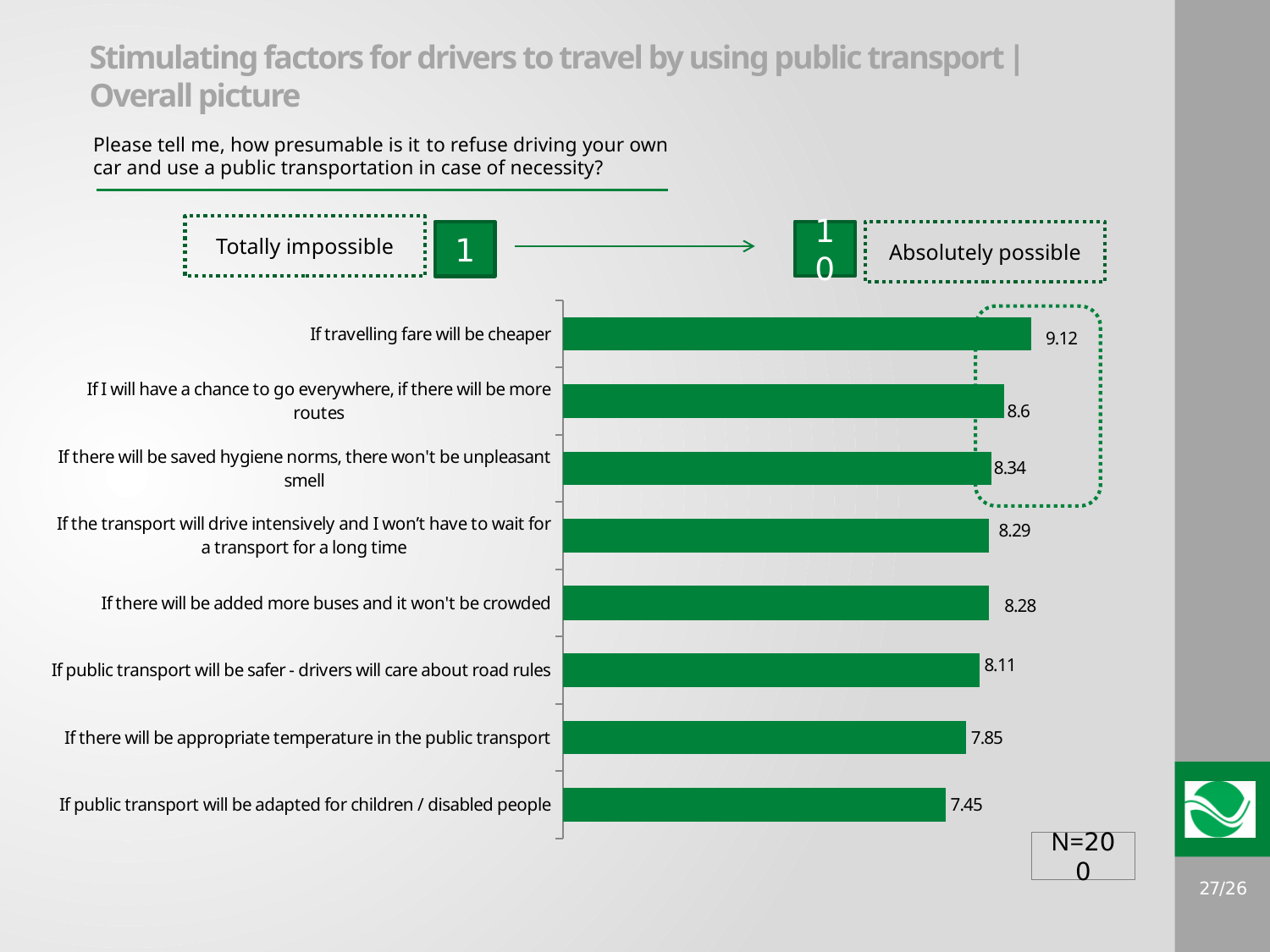
What is the difference between the values for "If travelling fare will be cheaper" and "If public transport will be adapted for children / disabled people"? 1.67 What sample size (N) is shown on the slide? N=200 Which has a larger value: "If there will be added more buses and it won't be crowded" or "If there will be appropriate temperature in the public transport"? If there will be added more buses and it won't be crowded What is the difference between the values for "If I will have a chance to go everywhere, if there will be more routes" and "If there will be saved hygiene norms, there won't be unpleasant smell"? 0.26 What is the value for "If travelling fare will be cheaper"? 9.12 What is the value for "If public transport will be safer - drivers will care about road rules"? 8.11 What is the value for "If public transport will be adapted for children / disabled people"? 7.45 Which factor has the highest value? If travelling fare will be cheaper What kind of chart is shown on the slide? Bar chart How many factors are shown in the chart? 8 What is the value for "If there will be appropriate temperature in the public transport"? 7.85 Which factor has the lowest value? If public transport will be adapted for children / disabled people